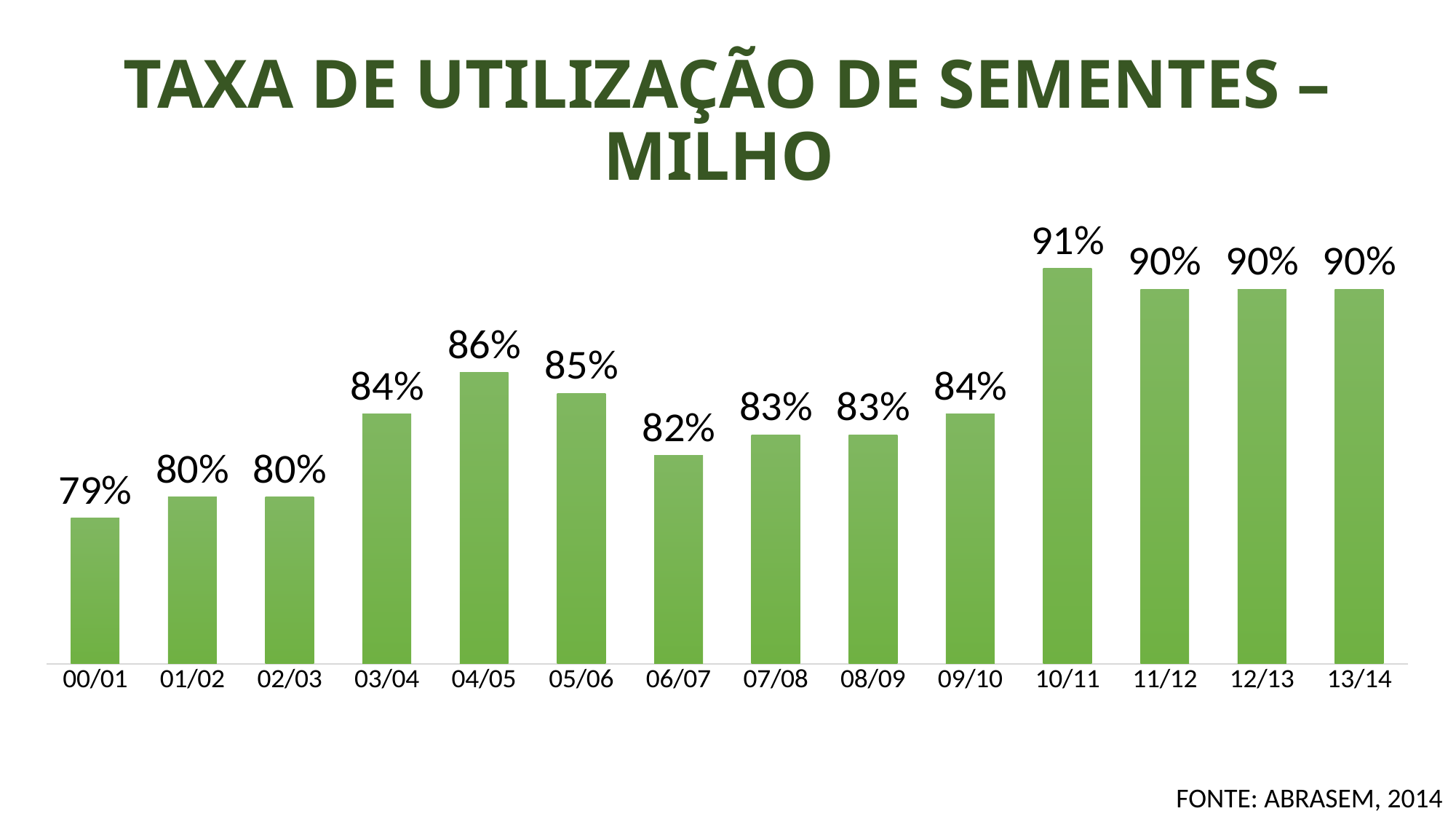
What is the seed utilization rate for 00/01? 79% Which season has the highest seed utilization rate? 10/11 Do the values generally rise or fall from 00/01 to 13/14? Rise Which is larger, the value for 05/06 or the value for 09/10? 05/06 What is the title of the chart? TAXA DE UTILIZAÇÃO DE SEMENTES – MILHO Which season has the lowest seed utilization rate? 00/01 What is the value shown for 06/07? 82% What is the value shown for 04/05? 86% What is the difference between the values for 10/11 and 00/01? 12% How many seasons are shown on the x axis? 14 What kind of chart is shown on the slide? Bar chart What is the difference between the values for 04/05 and 06/07? 4%